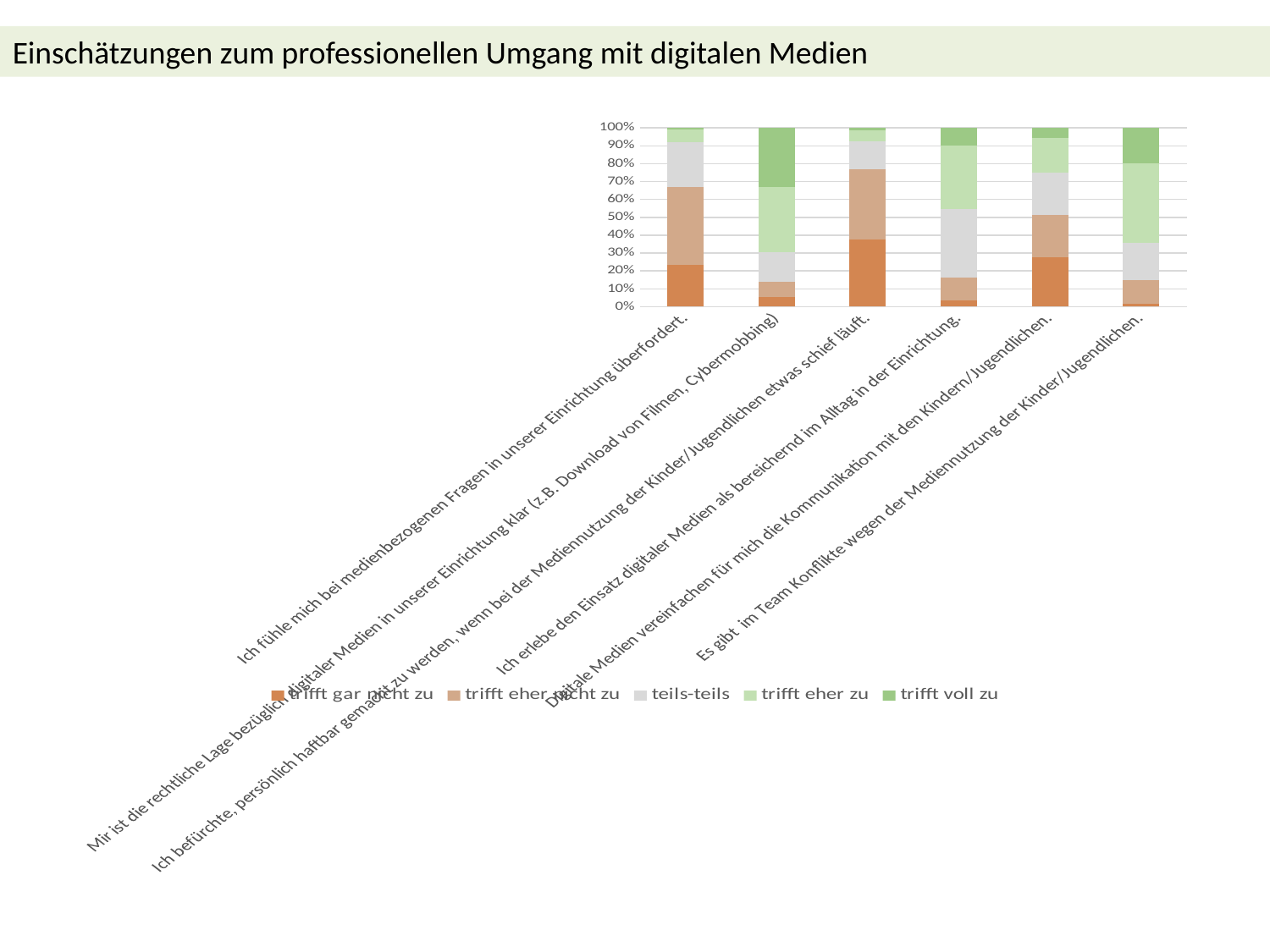
Is the 'trifft gar nicht zu' share for 'Es gibt im Team Konflikte wegen der Mediennutzung der Kinder/Jugendlichen.' greater or less than 10%? less What does each stacked bar total on the y axis? 100% What is the first entry in the chart legend? trifft gar nicht zu Is the 'trifft voll zu' share for 'Mir ist die rechtliche Lage bezüglich digitaler Medien in unserer Einrichtung klar (z.B. Download von Filmen, Cybermobbing)' greater or less than 20%? greater What is the last entry in the chart legend? trifft voll zu What kind of chart is shown on the slide? stacked bar chart How many categories (statements) are plotted along the x axis? 6 Is the 'trifft gar nicht zu' share for 'Ich erlebe den Einsatz digitaler Medien als bereichernd im Alltag in der Einrichtung.' greater or less than 10%? less Which statement has the largest 'trifft gar nicht zu' segment? Ich befürchte, persönlich haftbar gemacht zu werden, wenn bei der Mediennutzung der Kinder/Jugendlichen etwas schief läuft. Which has the larger 'trifft voll zu' segment: 'Mir ist die rechtliche Lage bezüglich digitaler Medien in unserer Einrichtung klar (z.B. Download von Filmen, Cybermobbing)' or 'Es gibt im Team Konflikte wegen der Mediennutzung der Kinder/Jugendlichen.'? Mir ist die rechtliche Lage bezüglich digitaler Medien in unserer Einrichtung klar (z.B. Download von Filmen, Cybermobbing) How many series does the legend list? 5